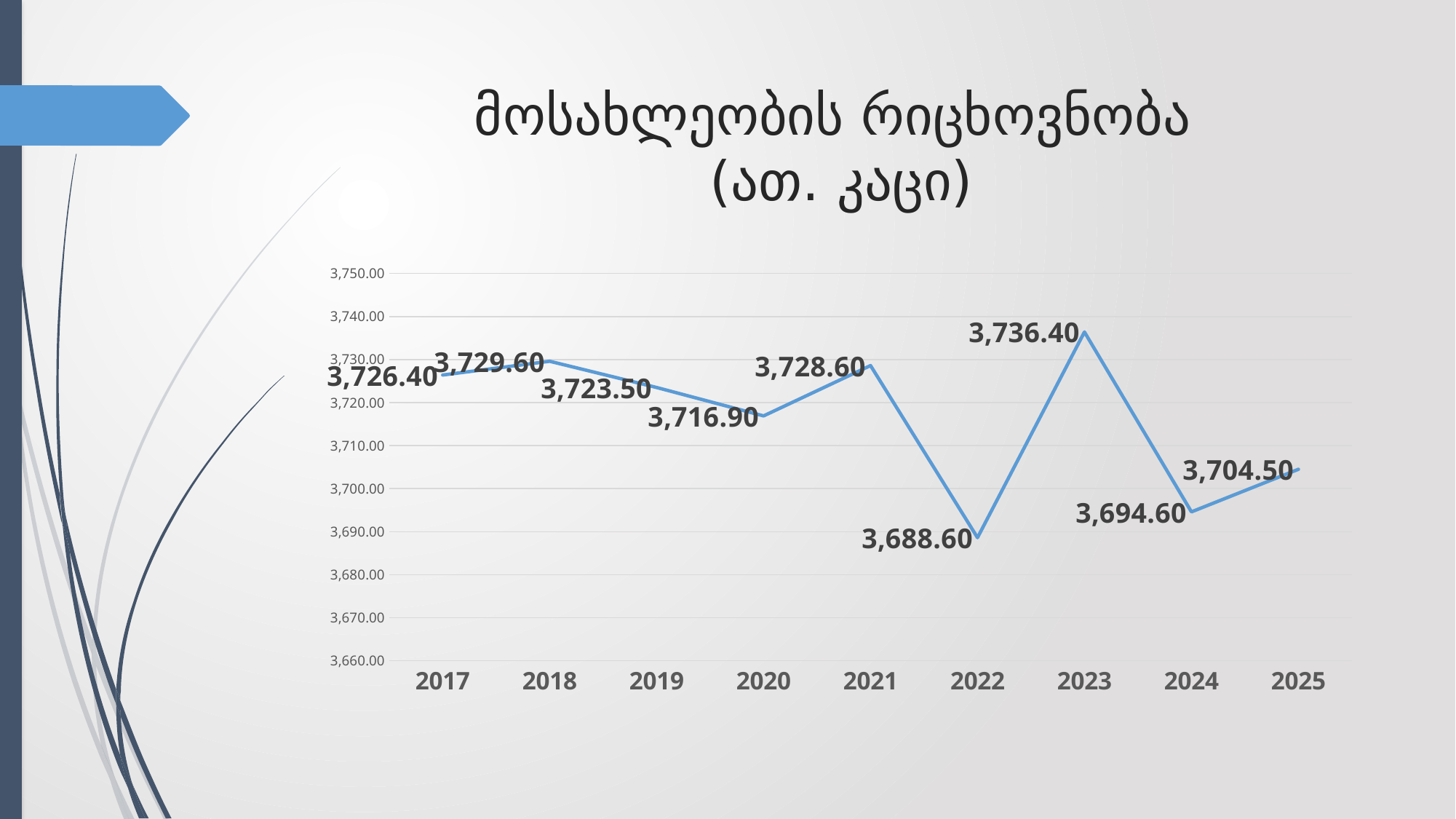
What is the difference between the values for 2023 and 2022? 47.80 What type of chart is shown on the slide? line chart Is the value for 2024 greater or less than 3,700.00? less What is the difference between the values for 2018 and 2017? 3.20 Which year has the highest value? 2023 Does the value rise or fall from 2018 to 2020? fall What is the value for 2022? 3,688.60 Which is larger, the value for 2021 or the value for 2019? 2021 Which year has the lowest value? 2022 How many years are plotted on the x axis? 9 What is the value for 2025? 3,704.50 What is the value for 2017? 3,726.40